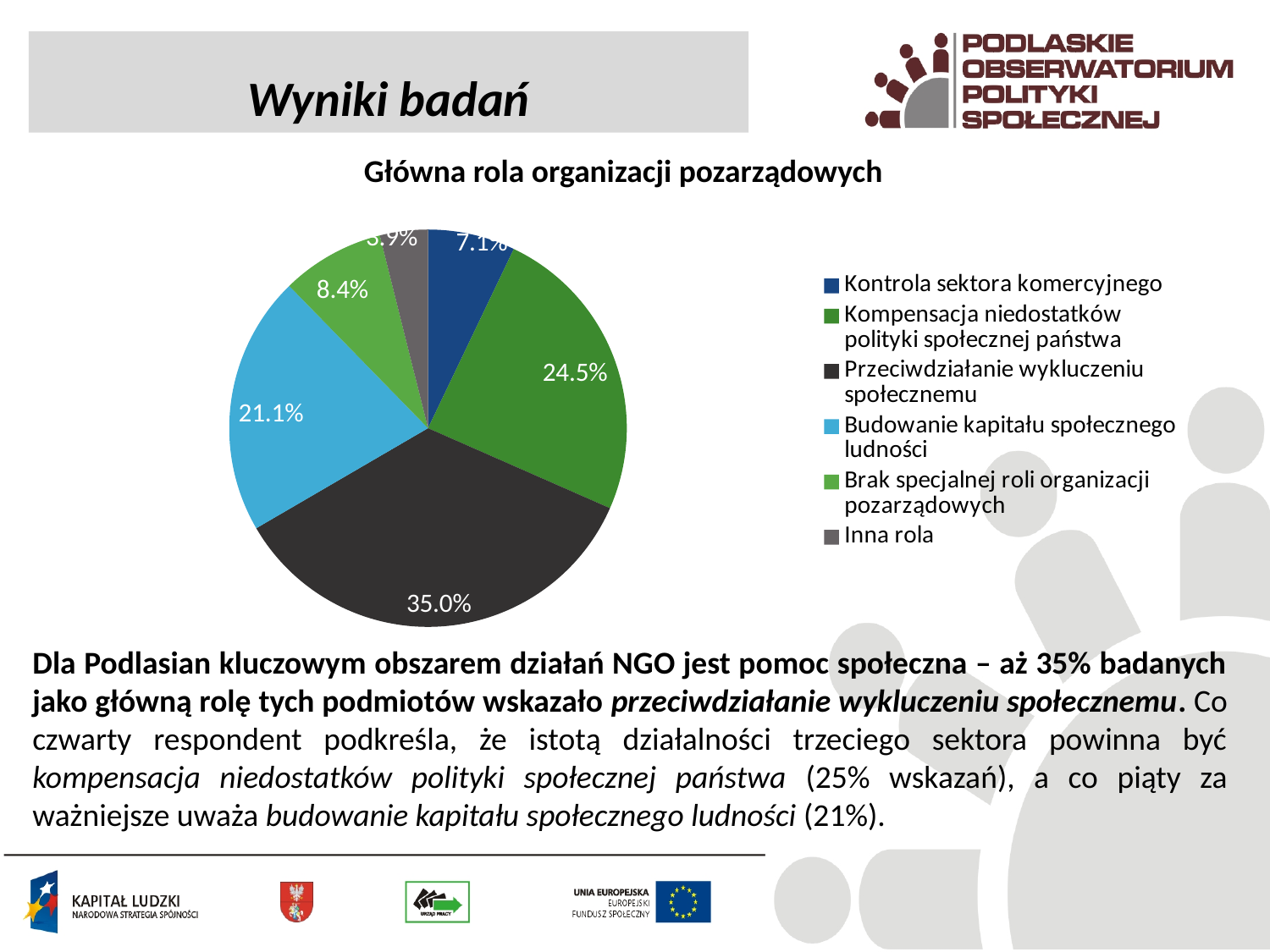
How many categories does the legend list? 6 What is the title of the chart? Główna rola organizacji pozarządowych What percentage is shown for "Brak specjalnej roli organizacji pozarządowych"? 8.4% What type of chart is shown on the slide? Pie chart Which category has the largest share of the pie? Przeciwdziałanie wykluczeniu społecznemu What percentage is shown for "Przeciwdziałanie wykluczeniu społecznemu"? 35.0% What percentage is shown for "Kontrola sektora komercyjnego"? 7.1% Which is larger: the share for "Budowanie kapitału społecznego ludności" or for "Brak specjalnej roli organizacji pozarządowych"? Budowanie kapitału społecznego ludności Which category has the smallest share of the pie? Inna rola What percentage is shown for "Budowanie kapitału społecznego ludności"? 21.1% What percentage is shown for "Kompensacja niedostatków polityki społecznej państwa"? 24.5% What is the difference in percentage points between "Przeciwdziałanie wykluczeniu społecznemu" and "Kompensacja niedostatków polityki społecznej państwa"? 10.5 percentage points